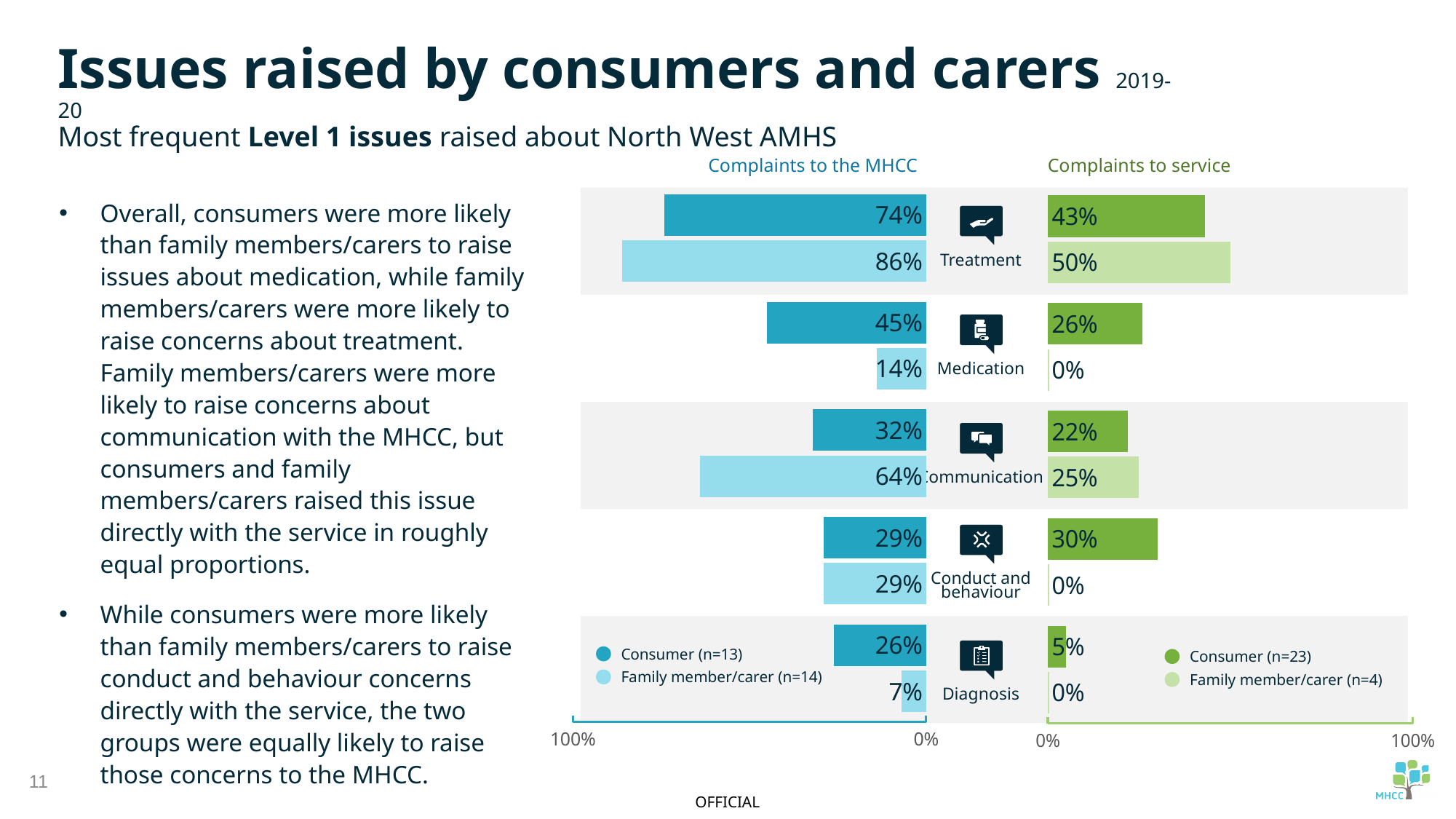
In the 'Complaints to service' chart, which issue has the lowest value for consumers? Diagnosis In the 'Complaints to the MHCC' chart, which issue has the highest value for family members/carers? Treatment In the 'Complaints to service' chart, what percentage of family members/carers raised issues about Treatment? 50% How many issue categories are shown in the 'Complaints to the MHCC' chart? 5 In the 'Complaints to the MHCC' chart, which is larger for Communication: the consumer value or the family member/carer value? Family member/carer In the 'Complaints to service' chart, what percentage of consumers raised issues about Diagnosis? 5% What type of chart is the 'Complaints to service' chart? Bar chart In the 'Complaints to the MHCC' chart, what percentage of consumers raised issues about Treatment? 74% According to the legend of the 'Complaints to service' chart, what is the sample size (n) for consumers? n=23 How many series does the legend of the 'Complaints to service' chart list? 2 In the 'Complaints to the MHCC' chart, what percentage of family members/carers raised issues about Communication? 64% In the 'Complaints to the MHCC' chart, what is the difference between the consumer and family member/carer values for Medication? 31%